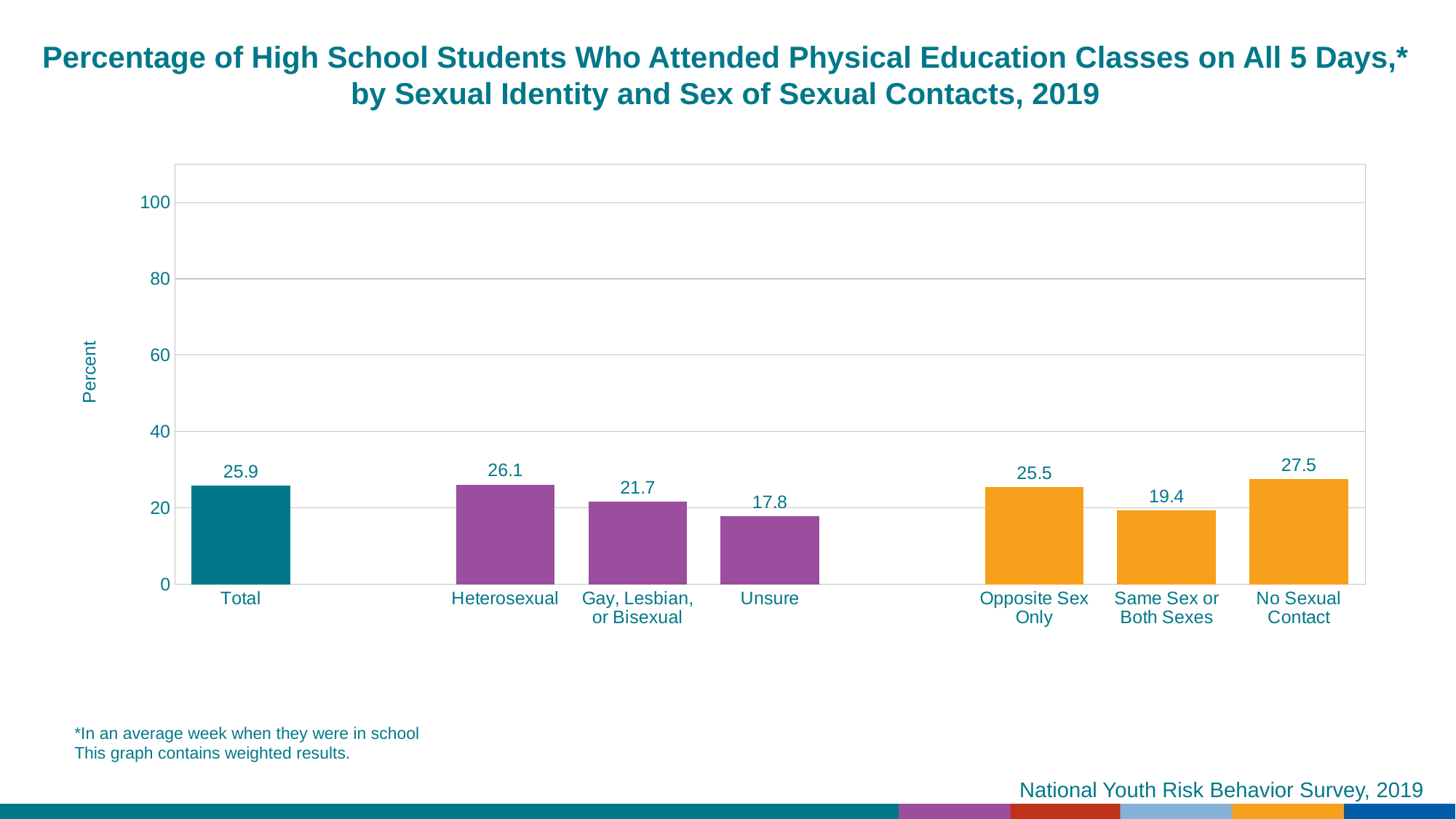
Which category has the lowest value? Unsure Which is larger, the value for Opposite Sex Only or the value for Same Sex or Both Sexes? Opposite Sex Only What is the value for Gay, Lesbian, or Bisexual? 21.7 What kind of chart is shown on the slide? bar chart Which category has the highest value? No Sexual Contact What is the value for Same Sex or Both Sexes? 19.4 What is the value for Total? 25.9 What is the difference between the values for Heterosexual and Unsure? 8.3 What is the difference between the values for No Sexual Contact and Same Sex or Both Sexes? 8.1 What is the value for Unsure? 17.8 Is the value for Heterosexual greater or less than 40? less How many bars are shown in the chart? 7